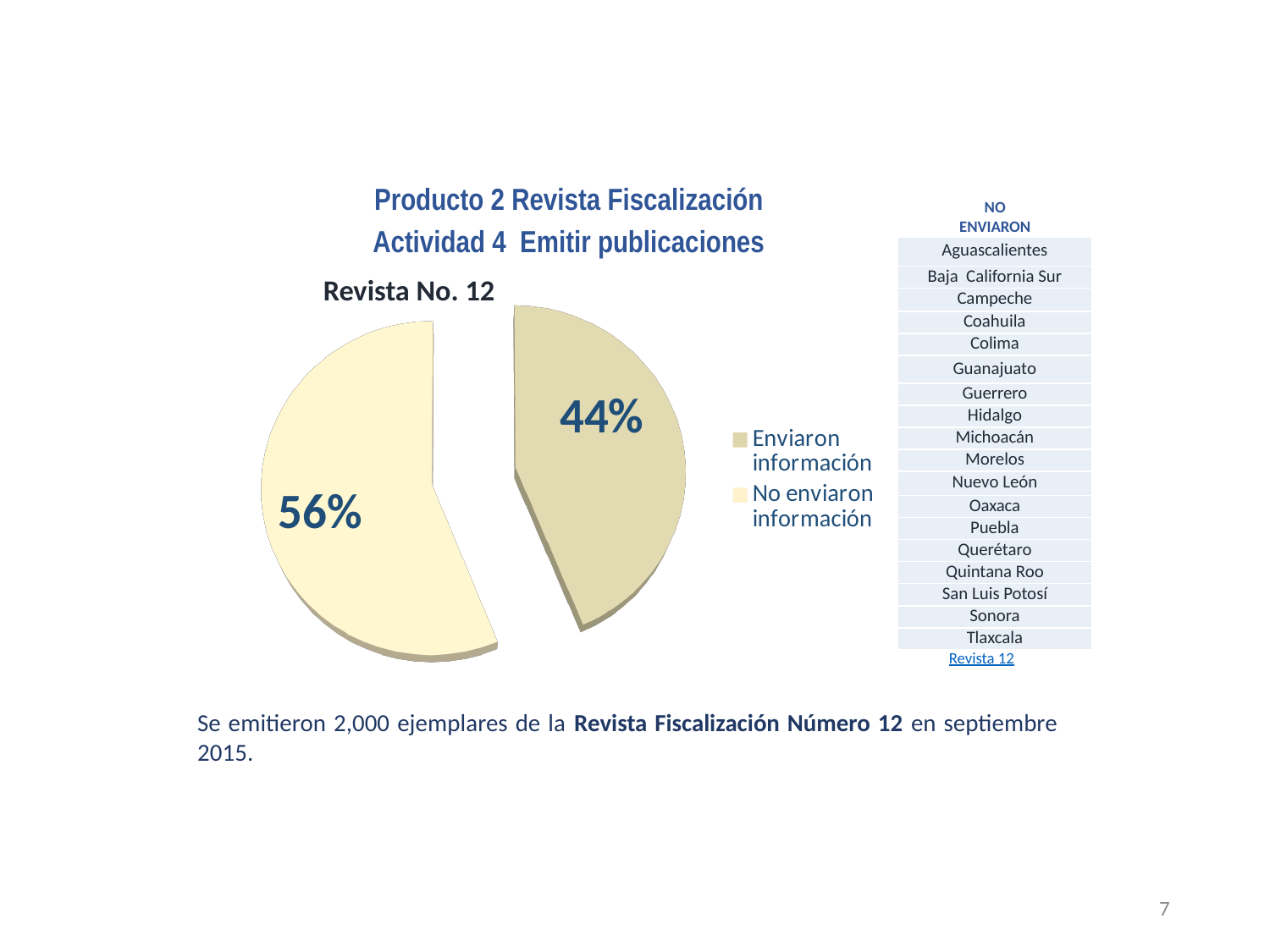
Is the share for "No enviaron información" greater or less than 50%? greater What kind of chart is shown on the slide? pie chart What share of the pie is labelled "Enviaron información"? 44% Is the share for "Enviaron información" greater or less than 50%? less How many entries does the legend list? 2 Which is larger: the "Enviaron información" slice or the "No enviaron información" slice? No enviaron información Which slice of the pie is the smallest? Enviaron información Which slice of the pie is the largest? No enviaron información What is the title of the chart? Revista No. 12 How many slices does the pie chart have? 2 What is the difference in percentage points between the "No enviaron información" and "Enviaron información" slices? 12 What share of the pie is labelled "No enviaron información"? 56%